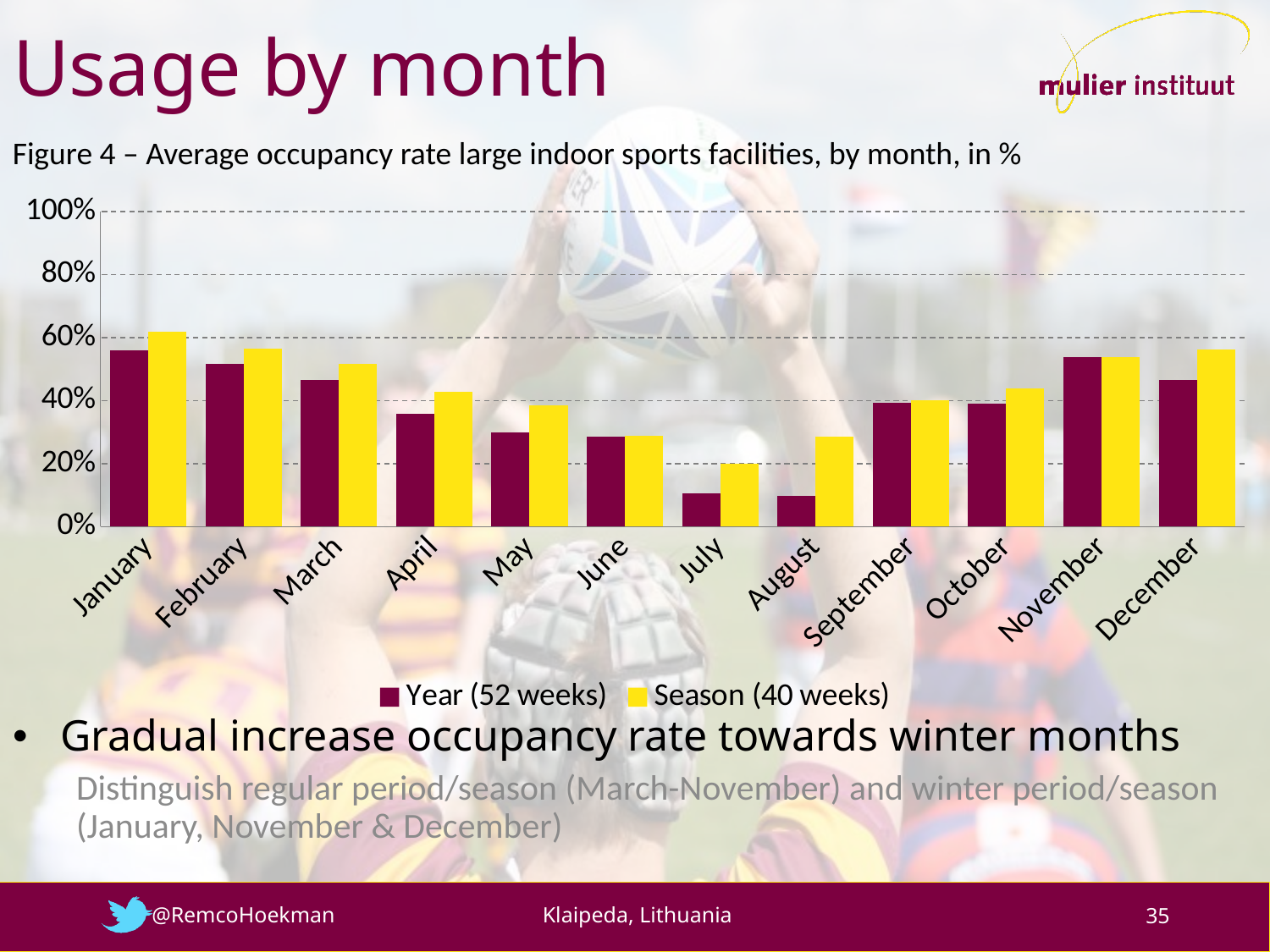
Is the Year (52 weeks) value for July greater or less than 20%? less What kind of chart is shown on the slide? bar chart Do the Year (52 weeks) values rise or fall from January to August? fall Is the Season (40 weeks) value for December greater or less than 40%? greater How many months are shown on the x axis of the chart? 12 Which month has the highest value for the Season (40 weeks) series? January Is the Year (52 weeks) value for January greater or less than 40%? greater How many series does the chart legend list? 2 For the Year (52 weeks) series, which is larger: November or August? November What are the two series named in the chart legend? Year (52 weeks) and Season (40 weeks) Which month has the lowest value for the Season (40 weeks) series? July In July, which series has the larger value: Year (52 weeks) or Season (40 weeks)? Season (40 weeks)